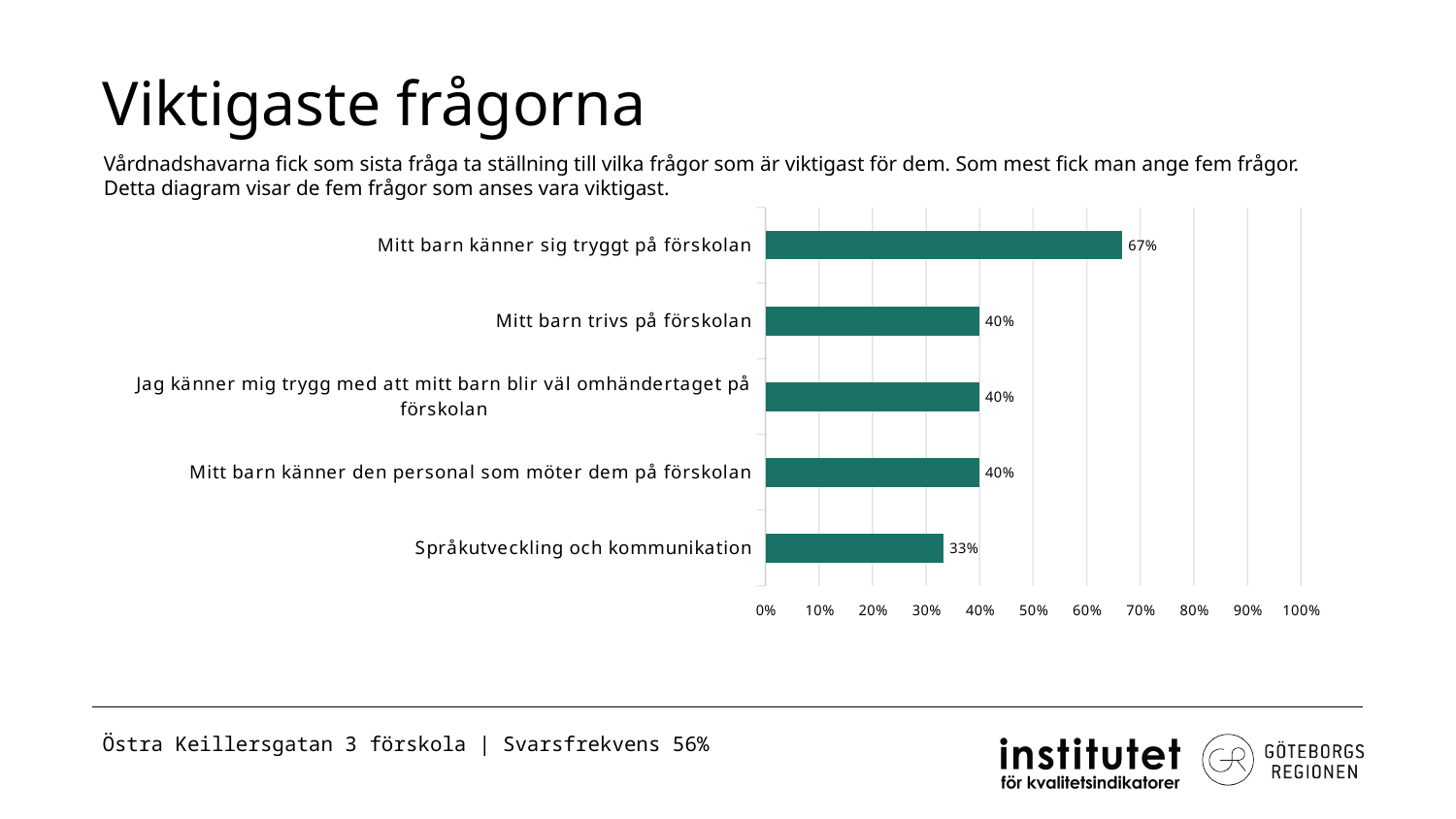
Which category has the highest value? Mitt barn känner sig tryggt på förskolan Is the value for "Mitt barn känner sig tryggt på förskolan" greater or less than 50%? greater What is the value for "Språkutveckling och kommunikation"? 33% What is the value for "Mitt barn känner sig tryggt på förskolan"? 67% What is the value for "Mitt barn trivs på förskolan"? 40% What is the title of the slide containing the chart? Viktigaste frågorna What kind of chart is shown on the slide? Bar chart What is the difference between the values for "Mitt barn känner sig tryggt på förskolan" and "Mitt barn trivs på förskolan"? 27% How many categories are shown in the chart? 5 Which category has the lowest value? Språkutveckling och kommunikation Which is larger: the value for "Mitt barn känner den personal som möter dem på förskolan" or the value for "Språkutveckling och kommunikation"? Mitt barn känner den personal som möter dem på förskolan What is the difference between the values for "Mitt barn känner sig tryggt på förskolan" and "Språkutveckling och kommunikation"? 34%